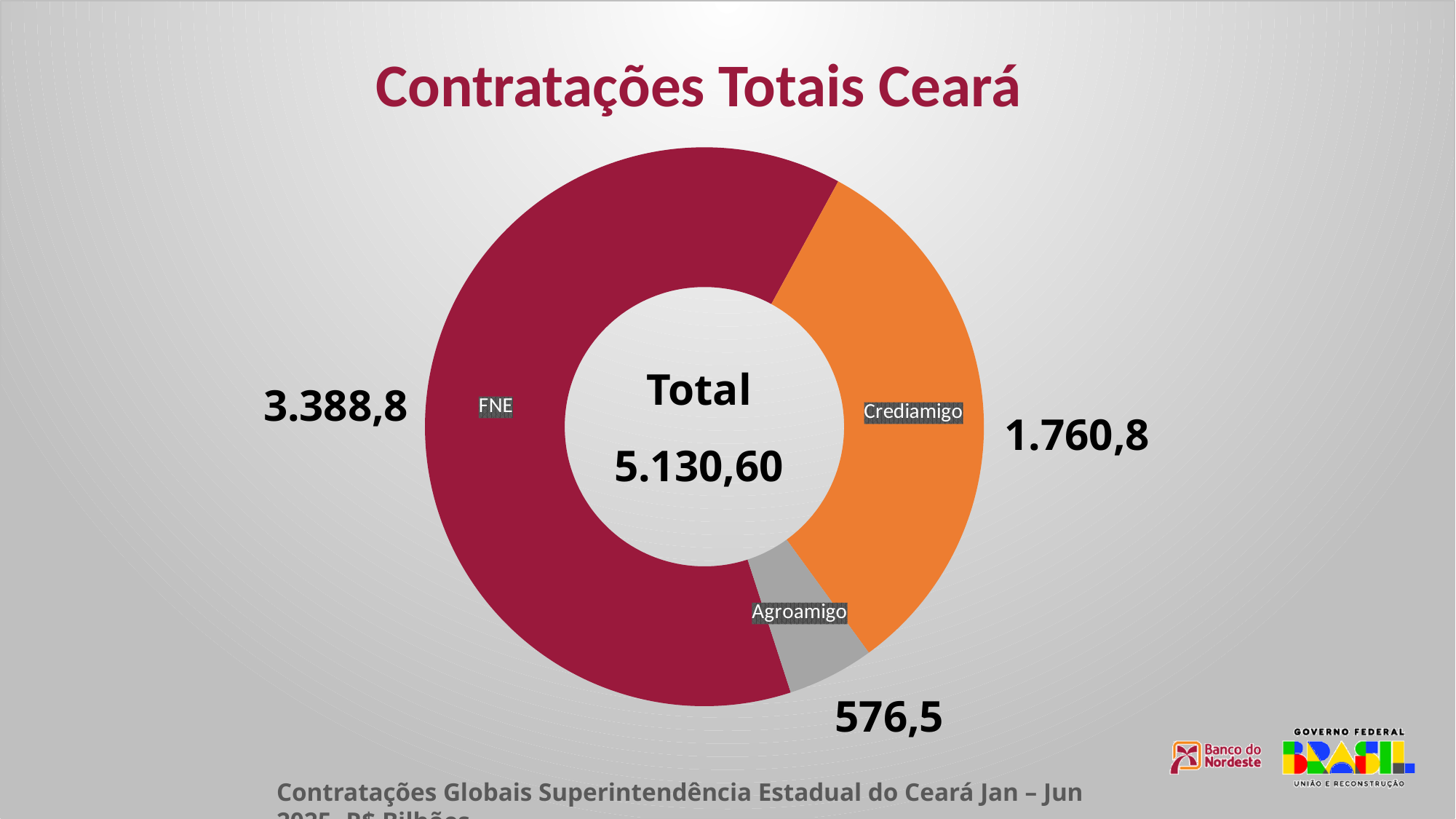
Which category has the largest slice? FNE Which category has the smallest slice? Agroamigo Which is larger, Crediamigo or Agroamigo? Crediamigo What is the title of the chart? Contratações Totais Ceará What is the difference between the FNE value and the Crediamigo value? 1.628,0 What is the value shown for Crediamigo? 1.760,8 What kind of chart is shown on the slide? Donut (pie) chart What is the difference between the Crediamigo value and the Agroamigo value? 1.184,3 What total is printed in the centre of the donut chart? 5.130,60 What is the value shown for FNE? 3.388,8 How many categories are shown in the chart? 3 What is the value shown for Agroamigo? 576,5